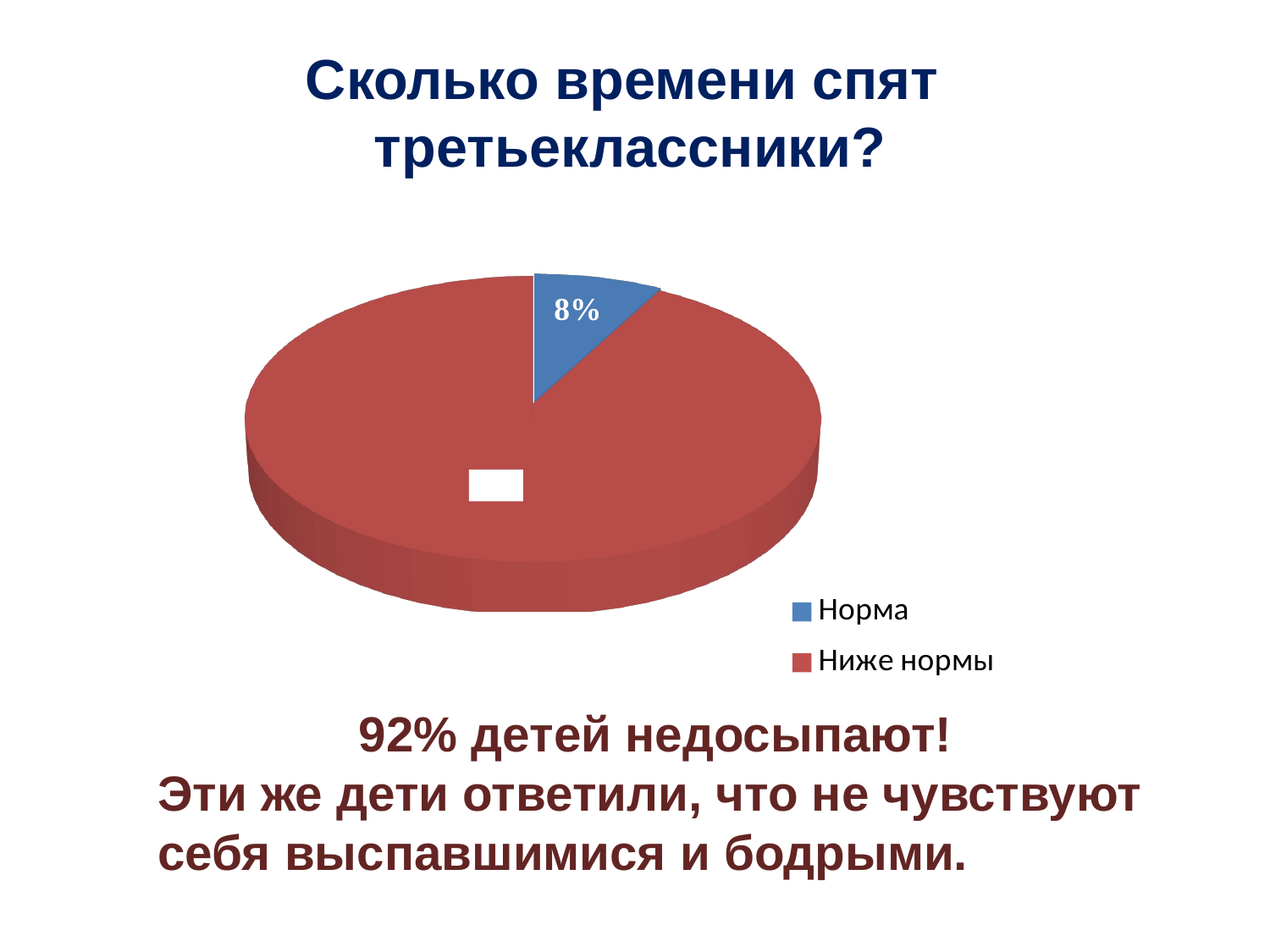
Which category has the smallest slice of the pie? Норма What percentage is shown for the "Норма" slice? 8% Which slice is larger, "Норма" or "Ниже нормы"? Ниже нормы How many slices does the pie chart have? 2 What is the title of the slide above the chart? Сколько времени спят третьеклассники? Is the share for "Ниже нормы" greater or less than 50%? greater How many entries does the legend list? 2 What share of the pie does "Норма" take? 8% What kind of chart is shown on the slide? pie chart Which category has the largest slice of the pie? Ниже нормы What colour is the "Норма" slice? blue